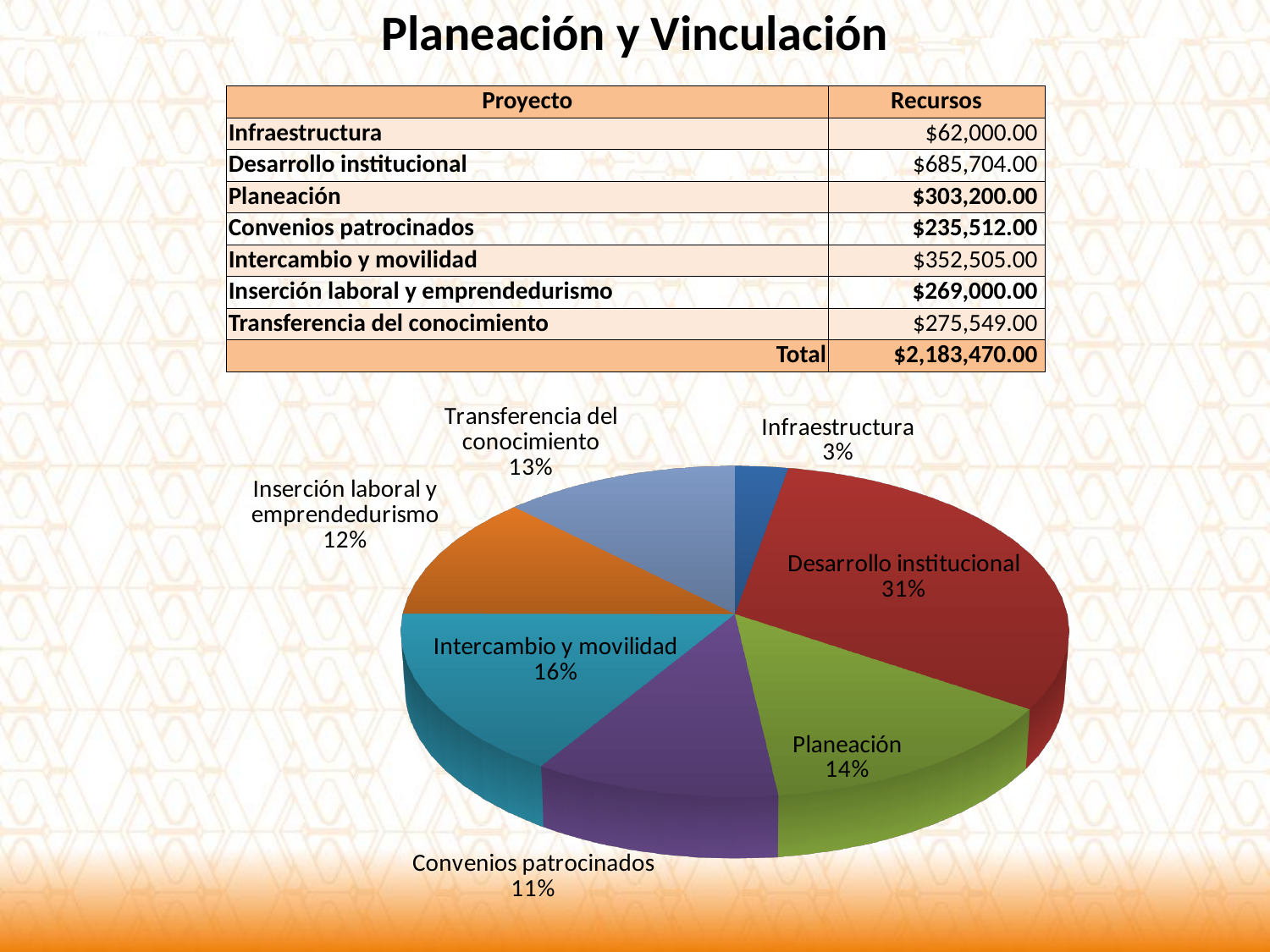
What kind of chart is shown on the slide? pie chart What colour is the Desarrollo institucional slice in the pie chart? red What share of the pie does Desarrollo institucional represent? 31% Which slice is larger, Intercambio y movilidad or Inserción laboral y emprendedurismo? Intercambio y movilidad How many slices does the pie chart have? 7 What share of the pie does Intercambio y movilidad represent? 16% Which slice of the pie chart is the smallest? Infraestructura What share of the pie does Infraestructura represent? 3% Which slice of the pie chart is the largest? Desarrollo institucional What is the difference in percentage points between the Desarrollo institucional slice and the Planeación slice? 17